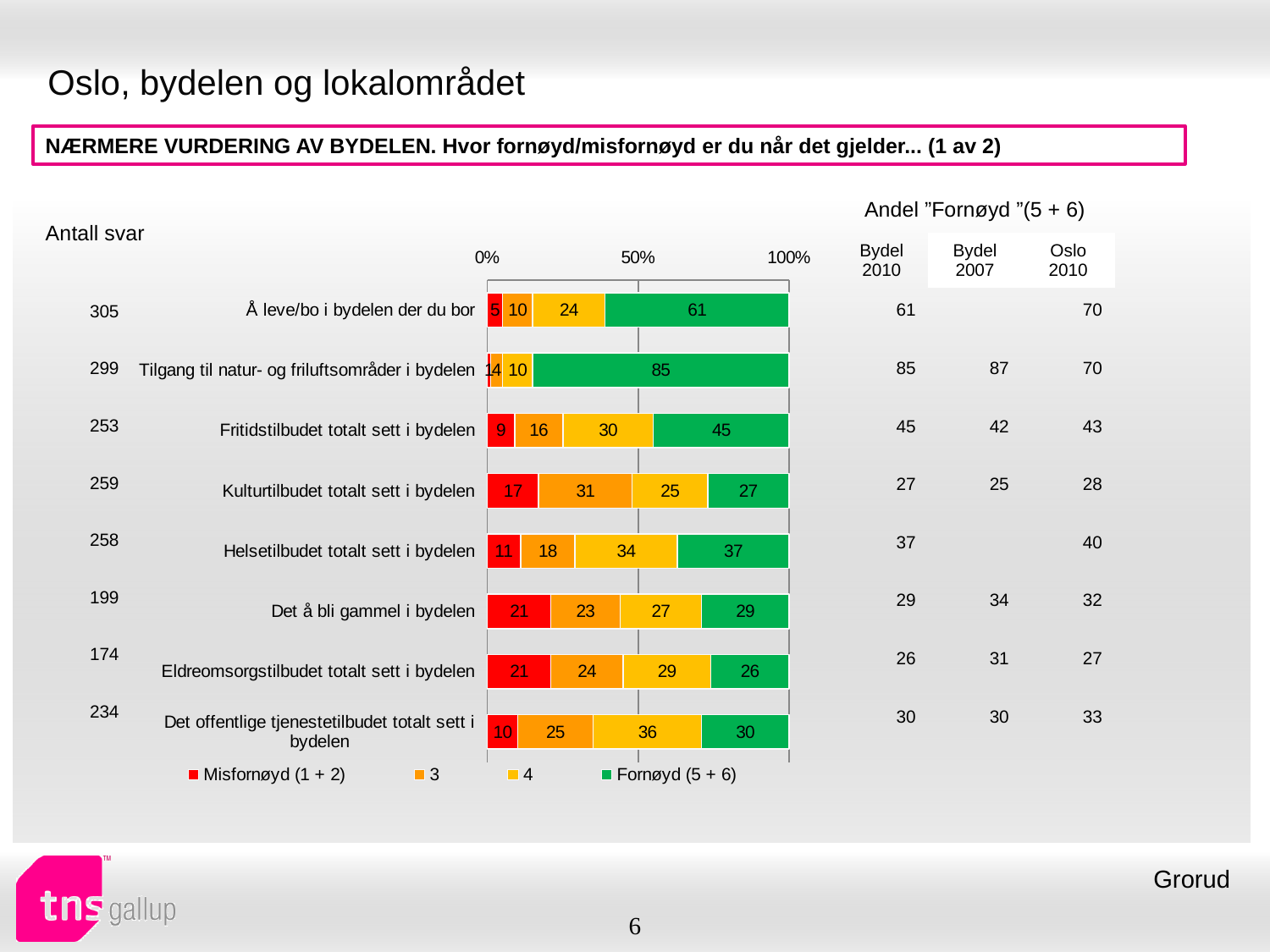
What colour represents the Fornøyd (5 + 6) series in the chart? green How many series does the chart legend list? 4 Which has a larger Misfornøyd (1 + 2) value: 'Det å bli gammel i bydelen' or 'Fritidstilbudet totalt sett i bydelen'? Det å bli gammel i bydelen What kind of chart is shown on the slide? stacked bar chart What is the value of series '3' for 'Helsetilbudet totalt sett i bydelen'? 18 What is the difference between the Fornøyd (5 + 6) values for 'Fritidstilbudet totalt sett i bydelen' and 'Helsetilbudet totalt sett i bydelen'? 8 Which category has the highest Fornøyd (5 + 6) value? Tilgang til natur- og friluftsområder i bydelen What is the Misfornøyd (1 + 2) value for 'Kulturtilbudet totalt sett i bydelen'? 17 Which category has the lowest Fornøyd (5 + 6) value? Eldreomsorgstilbudet totalt sett i bydelen What is the Fornøyd (5 + 6) value for 'Å leve/bo i bydelen der du bor'? 61 How many categories are plotted in the chart? 8 What is the value of series '4' for 'Det offentlige tjenestetilbudet totalt sett i bydelen'? 36